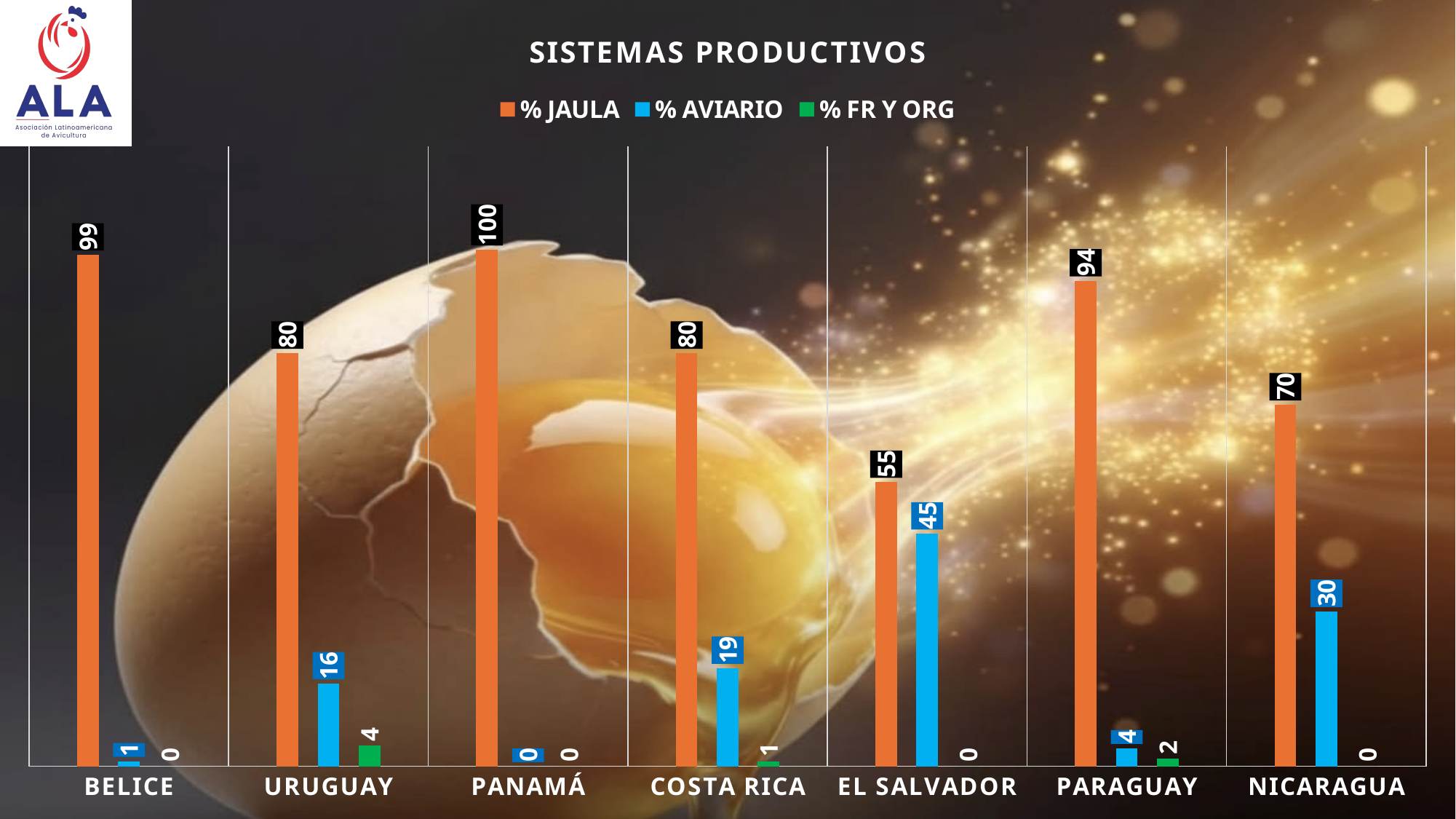
Which is larger, the % AVIARIO value for Costa Rica or for Uruguay? Costa Rica Which colour represents the % AVIARIO series? Blue Which country has the lowest % JAULA value? El Salvador Which country has the highest % JAULA value? Panamá What is the % JAULA value for Belice? 99 What is the % AVIARIO value for El Salvador? 45 What is the difference between the % JAULA and % AVIARIO values for Nicaragua? 40 What is the % FR Y ORG value for Uruguay? 4 What kind of chart is shown on the slide? Bar chart What is the title of the chart? SISTEMAS PRODUCTIVOS How many series does the legend list? 3 How many countries are shown on the x axis? 7